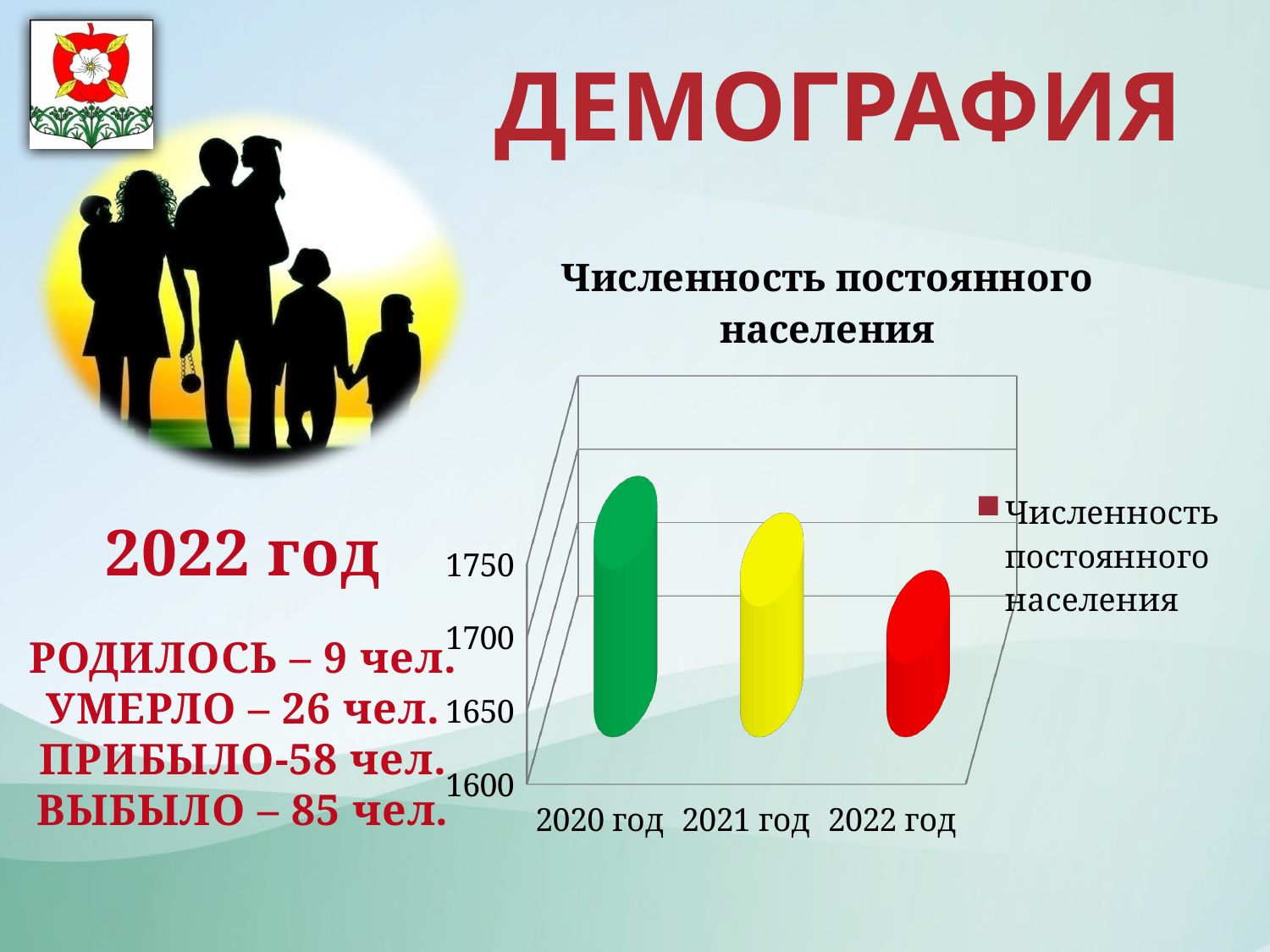
Is the value for 2021 год larger or smaller than the value for 2020 год? smaller How many series does the chart legend list? 1 Is the value for 2020 год larger or smaller than the value for 2022 год? larger What is the title of the chart? Численность постоянного населения Which year has the lowest value in the chart? 2022 год Which year has the highest value in the chart? 2020 год Is the value for 2020 год greater or less than 1700? greater Do the values rise or fall from 2020 год to 2022 год? fall What colour is the bar for 2022 год? red What kind of chart is shown on the slide? bar chart How many categories (years) are shown on the x axis of the chart? 3